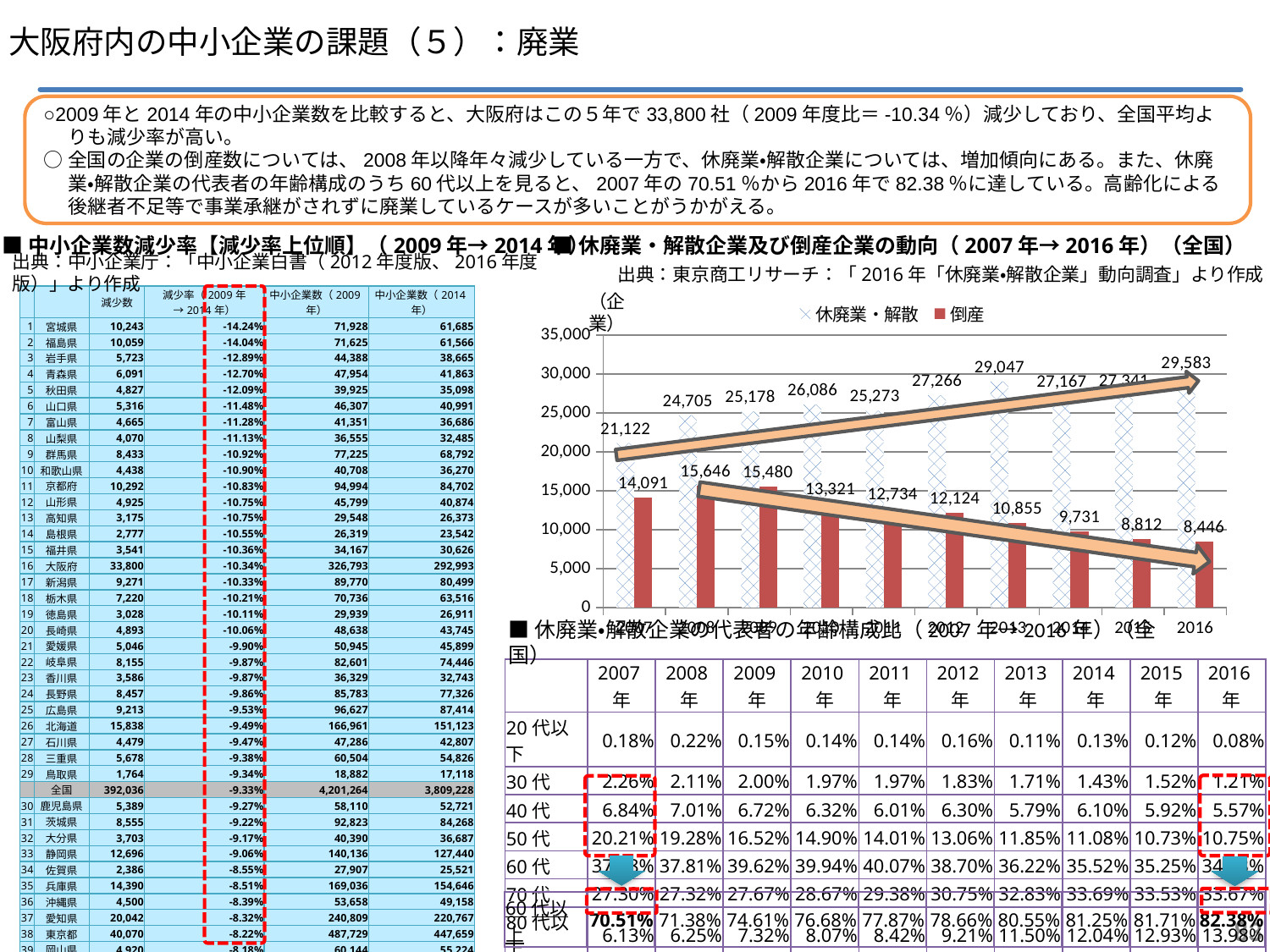
What is the difference between the 休廃業・解散 value and the 倒産 value for 2016? 21,137 How many series does the legend of the chart list? 2 What are the two series named in the chart legend? 休廃業・解散 and 倒産 What is the value of 休廃業・解散 for 2016 in the chart? 29,583 What is the value of 休廃業・解散 for 2007, the first year in the chart? 21,122 What is the value of 倒産 for 2007, the first year in the chart? 14,091 What is the value of 倒産 for 2016 in the chart? 8,446 What kind of chart is shown on the slide? bar chart What is the highest value shown for the 倒産 series in the chart? 15,646 Does the 倒産 series rise or fall from 2007 to 2016 in the chart? fall How many years (bar groups) are plotted in the chart? 10 What is the lowest value shown for the 休廃業・解散 series in the chart? 21,122